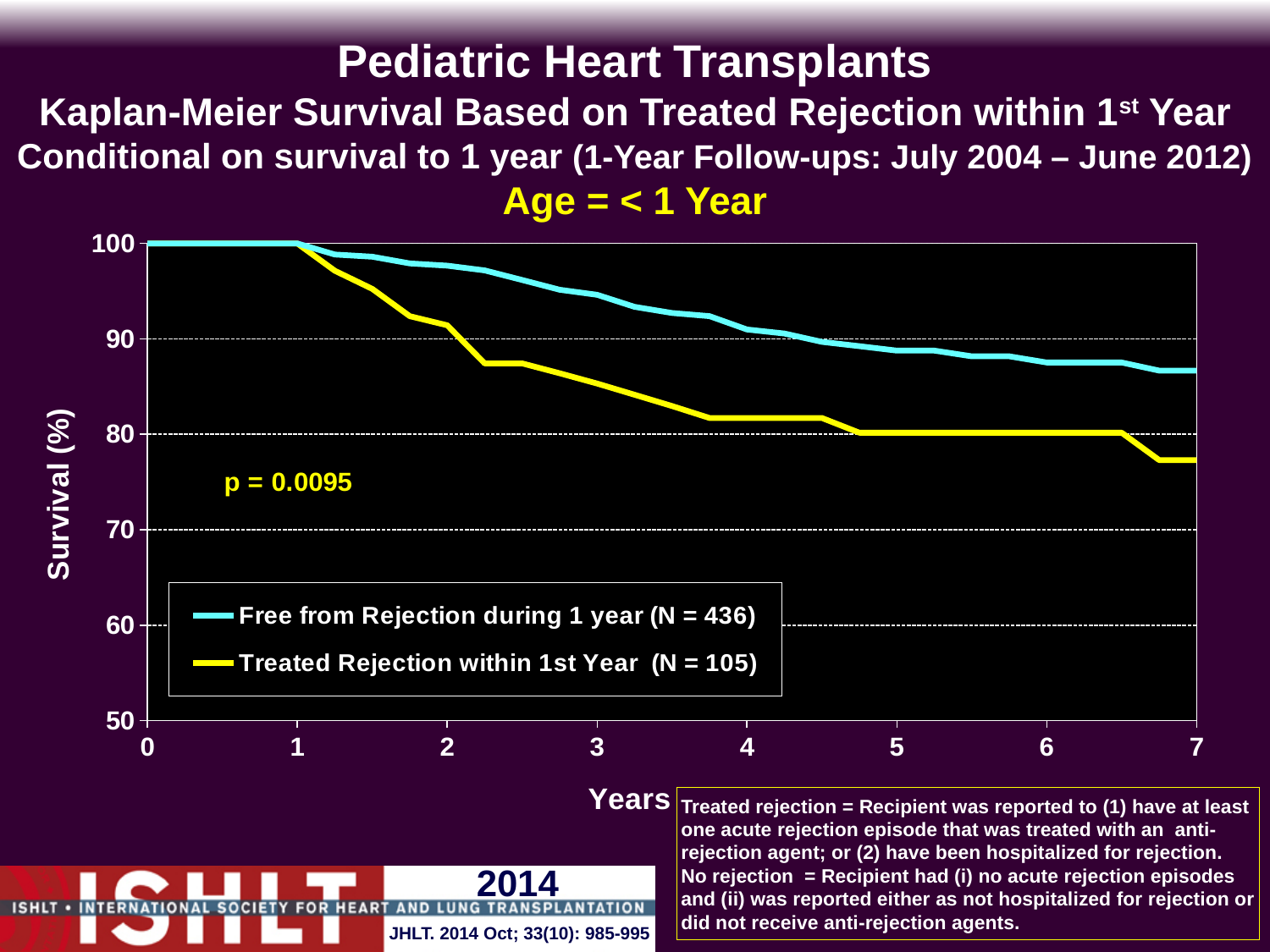
What kind of chart is shown on the slide? Line chart (Kaplan-Meier survival curve) What is the label of the y axis? Survival (%) What p-value is printed on the chart? p = 0.0095 At 7 years, which group has the higher survival: Free from Rejection during 1 year or Treated Rejection within 1st Year? Free from Rejection during 1 year Is the survival for Treated Rejection within 1st Year at 3 years greater or less than 90? less Is the survival for Free from Rejection during 1 year at 7 years greater or less than 80? greater How many series does the legend list? 2 Does survival for Treated Rejection within 1st Year rise or fall as years increase? Fall Is the survival for Free from Rejection during 1 year at 7 years greater or less than 90? less What is the highest value shown on the x axis (Years)? 7